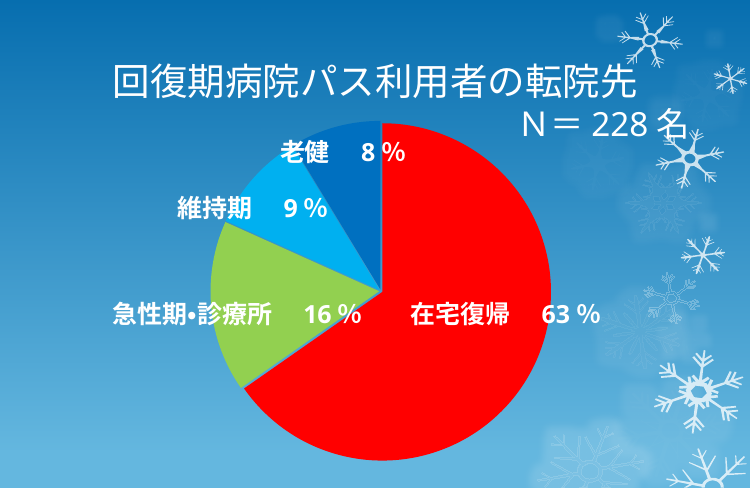
What percentage is shown for 維持期? 9 % What is the difference in percentage points between 在宅復帰 and 急性期•診療所? 47 What kind of chart is shown on the slide? pie chart Which is larger, the slice for 急性期•診療所 or the slice for 維持期? 急性期•診療所 What is the title of the chart? 回復期病院パス利用者の転院先 What sample size (N) is stated on the slide? 228 名 How many slices does the pie chart have? 4 What share of the pie does 在宅復帰 represent? 63 % What percentage is shown for 急性期•診療所? 16 % Which category has the smallest slice of the pie? 老健 What percentage is shown for 老健? 8 % Which category has the largest slice of the pie? 在宅復帰